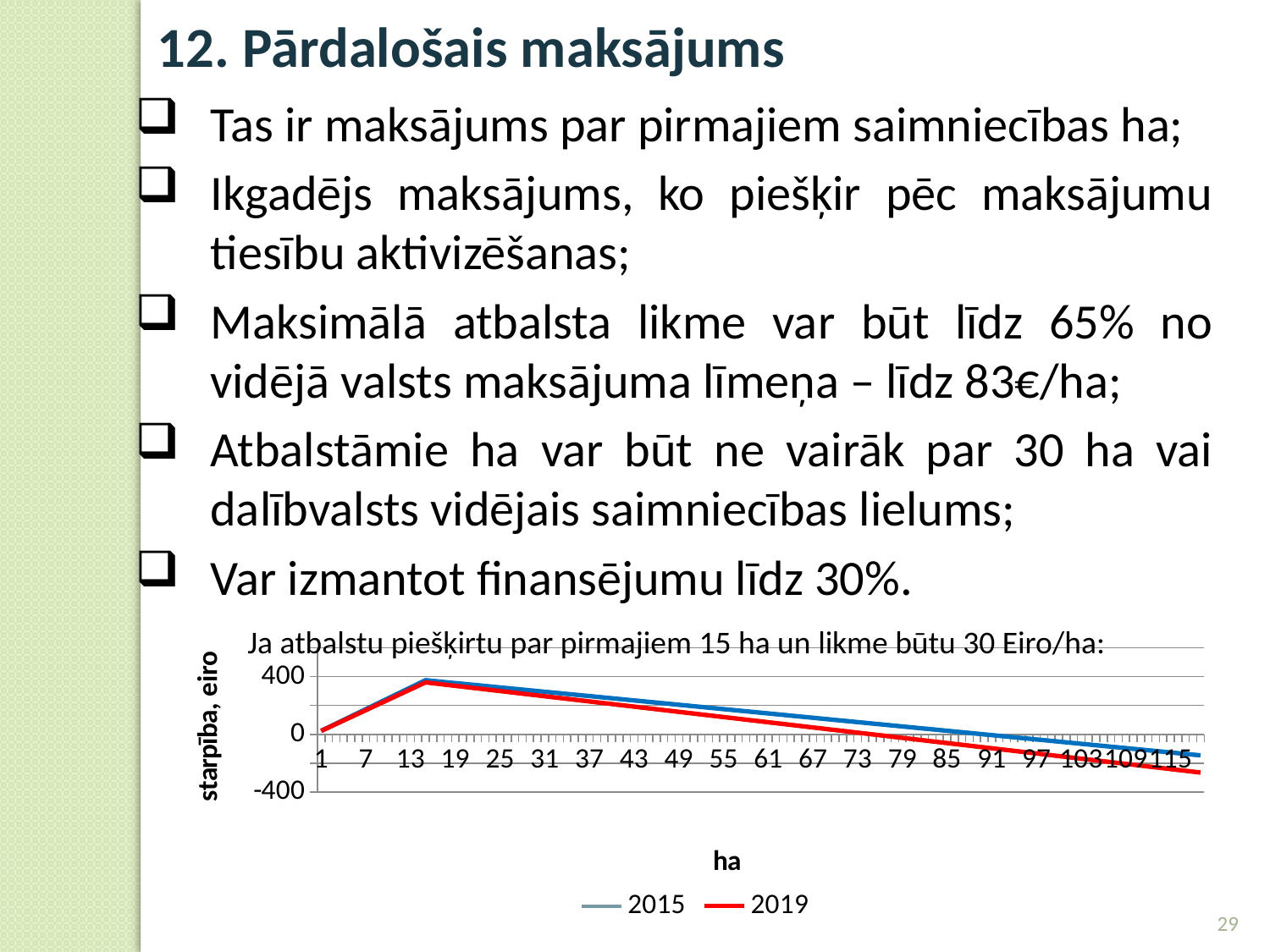
At 115 ha, is the value for the 2015 series greater or less than 0? less At 1 ha, is the value for the 2015 series greater or less than 400? less Between 1 ha and the peak, do the values rise or fall? rise At 115 ha, is the value for the 2019 series greater or less than 0? less How many series does the chart legend list? 2 After the peak near 15 ha, do the values rise or fall as ha increases? fall What kind of chart is shown on the slide? line chart What is the label of the chart's x axis? ha Which series are listed in the chart legend? 2015 and 2019 At 115 ha, which series has the higher value, 2015 or 2019? 2015 Which series is drawn in red? 2019